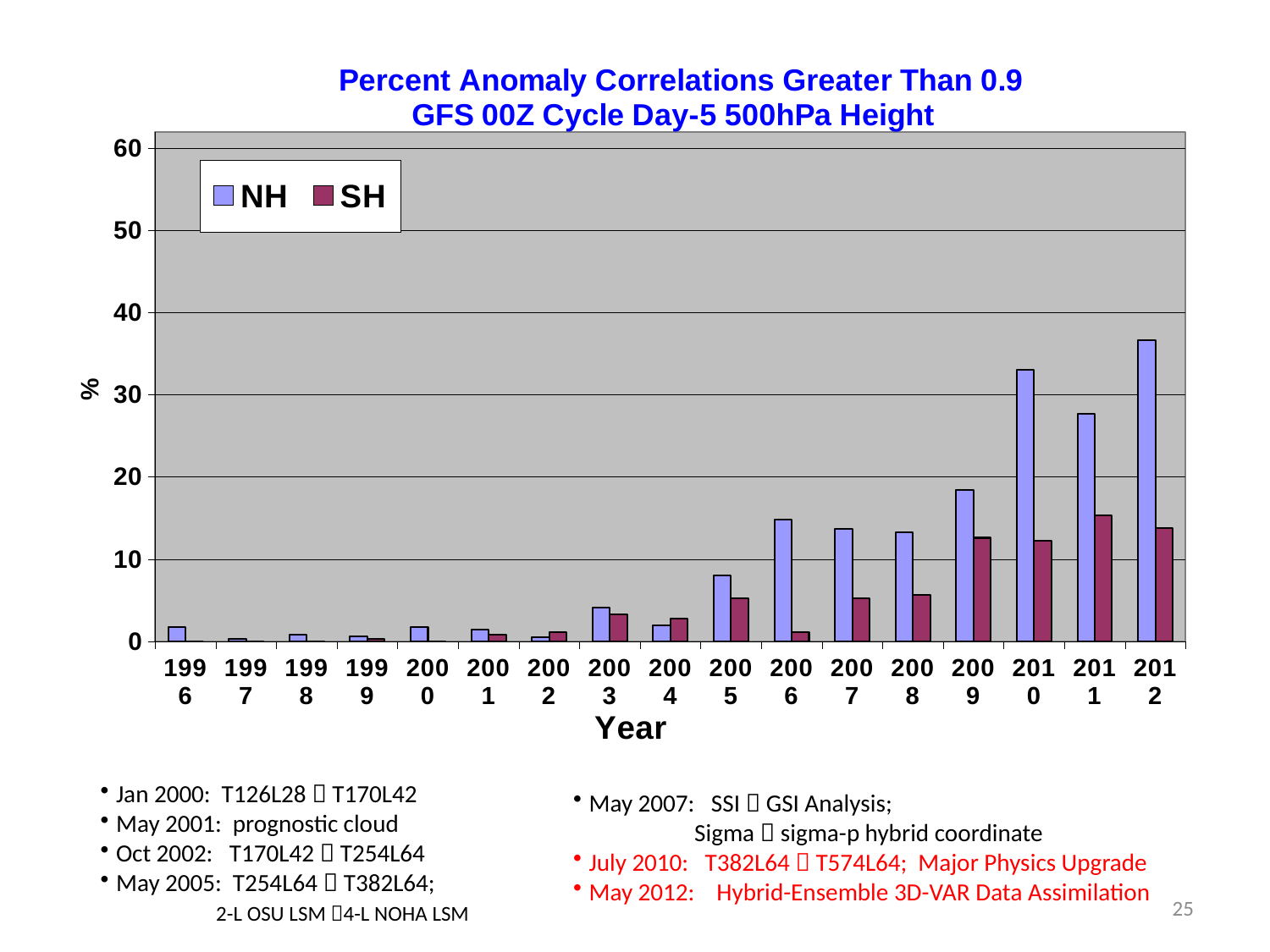
Is the NH value for 2011 greater or less than 30? less Does the NH series generally rise or fall from 1996 to 2012? rise Which is larger for 2005, the NH value or the SH value? NH Is the NH value for 2009 greater or less than 20? less Which year has the highest NH value? 2012 Which is larger, the NH value for 2010 or the NH value for 2011? NH value for 2010 Which year has the highest SH value? 2011 What kind of chart is shown on the slide? bar chart Is the NH value for 2012 greater or less than 30? greater How many years are shown on the x axis? 17 How many series does the legend list? 2